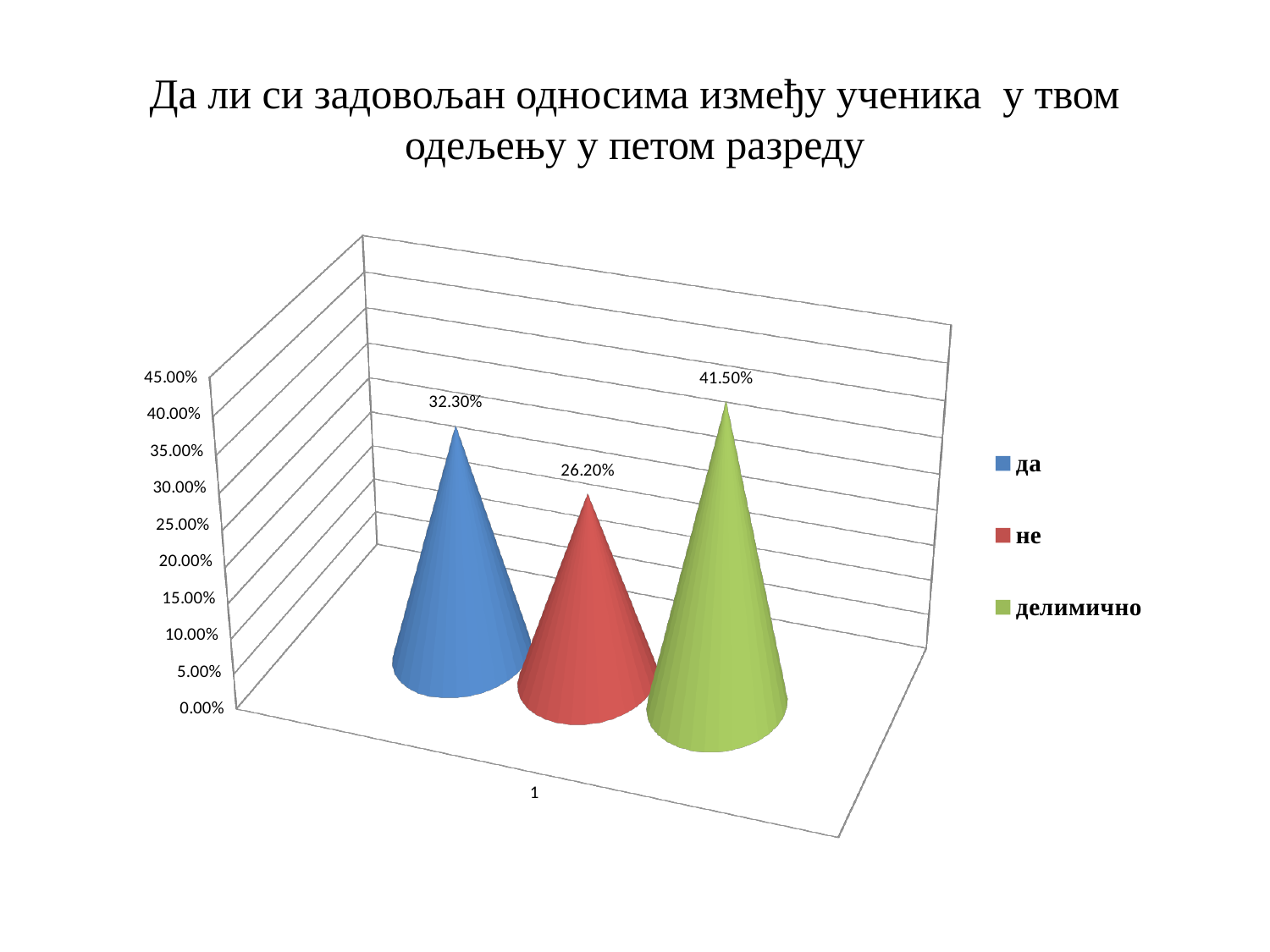
What is the value for не? 26.20% What is the difference between the values for да and не? 6.10% What is the difference between the values for делимично and да? 9.20% Which series has the lowest value? не How many series does the legend list? 3 Which is larger, the value for да or the value for не? да Is the value for делимично greater or less than 40.00%? greater What colour is the bar for не? red What kind of chart is shown on the slide? bar chart What is the value for делимично? 41.50% Which series has the highest value? делимично What is the value for да? 32.30%